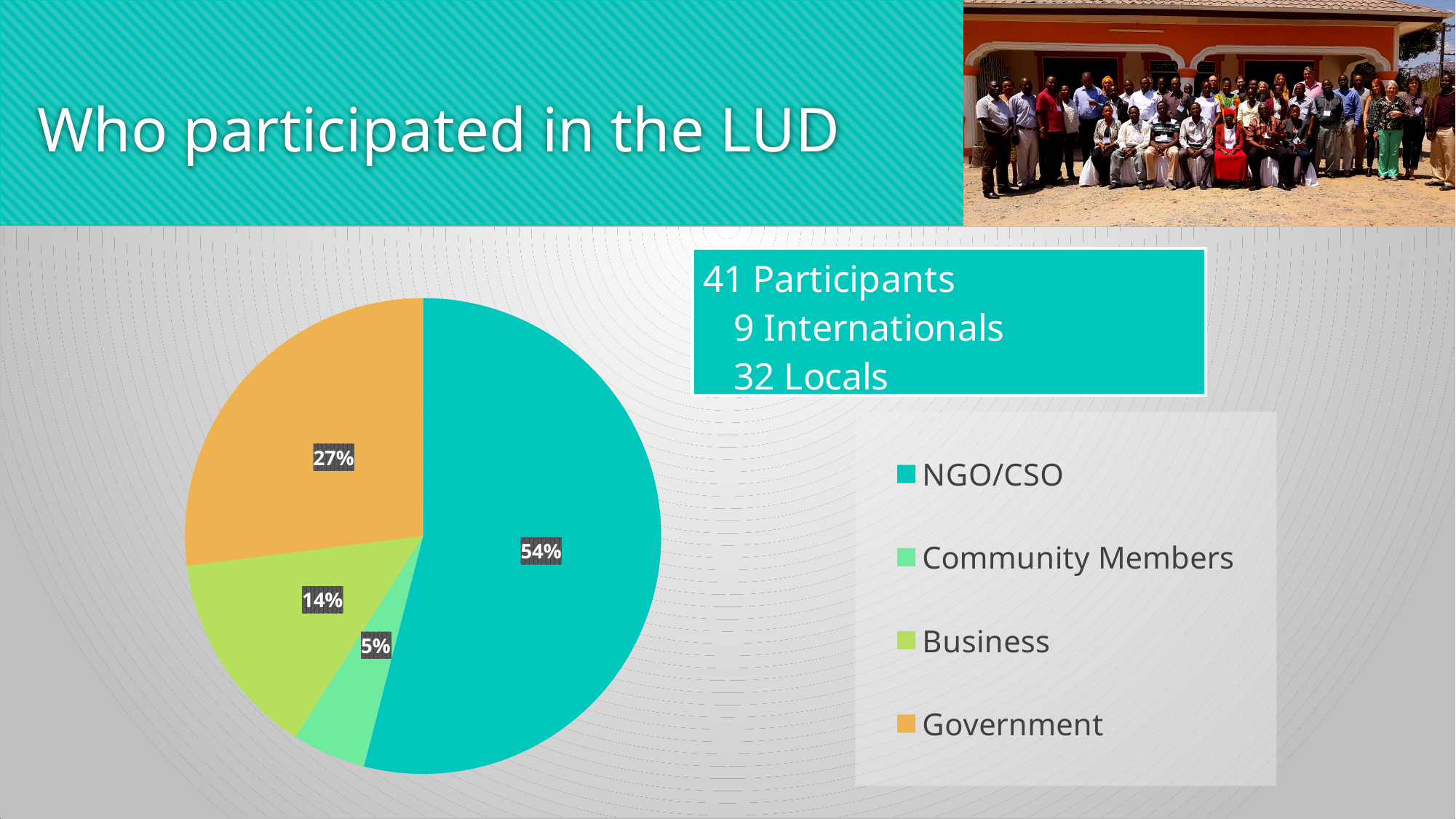
Which colour represents Government in the pie chart? orange What percentage of participants were NGO/CSO? 54% How many categories does the pie chart show? 4 What percentage of participants were Government? 27% Which category has the largest share of the pie? NGO/CSO What percentage of participants were Business? 14% Which category has the smallest share of the pie? Community Members What percentage of participants were Community Members? 5% What is the difference in percentage points between Business and Community Members? 9 Which is larger, the Business share or the Government share? Government What is the difference in percentage points between NGO/CSO and Government? 27 What kind of chart is shown on the slide? pie chart